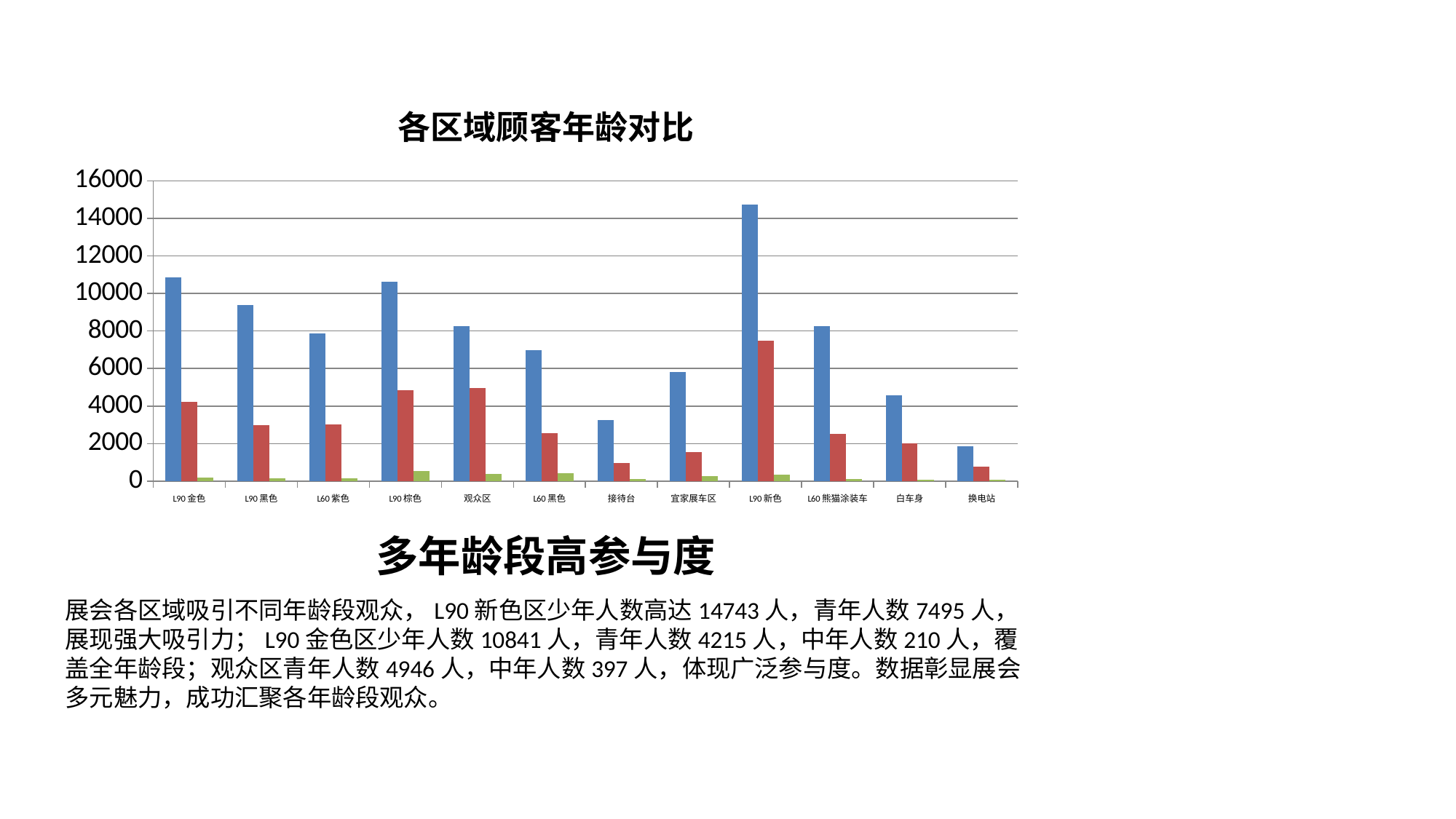
Which region has the tallest blue bar in the chart? L90 新色 According to the slide, how many 少年 visitors did the L90 新色 region have? 14743 人 What kind of chart is shown on the slide? bar chart How many categories (regions) are shown on the x axis of the chart? 12 How many bars are plotted for each region in the chart? 3 Is the blue bar for L90 黑色 greater or less than 8000? greater Which region has the tallest red bar in the chart? L90 新色 Which has the taller blue bar, L90 黑色 or L60 紫色? L90 黑色 What is the title of the chart? 各区域顾客年龄对比 Is the blue bar for 接待台 greater or less than 4000? less Which region has the shortest blue bar in the chart? 换电站 According to the slide, what is the difference in 少年 visitors between L90 新色 (14743) and L90 金色 (10841)? 3902